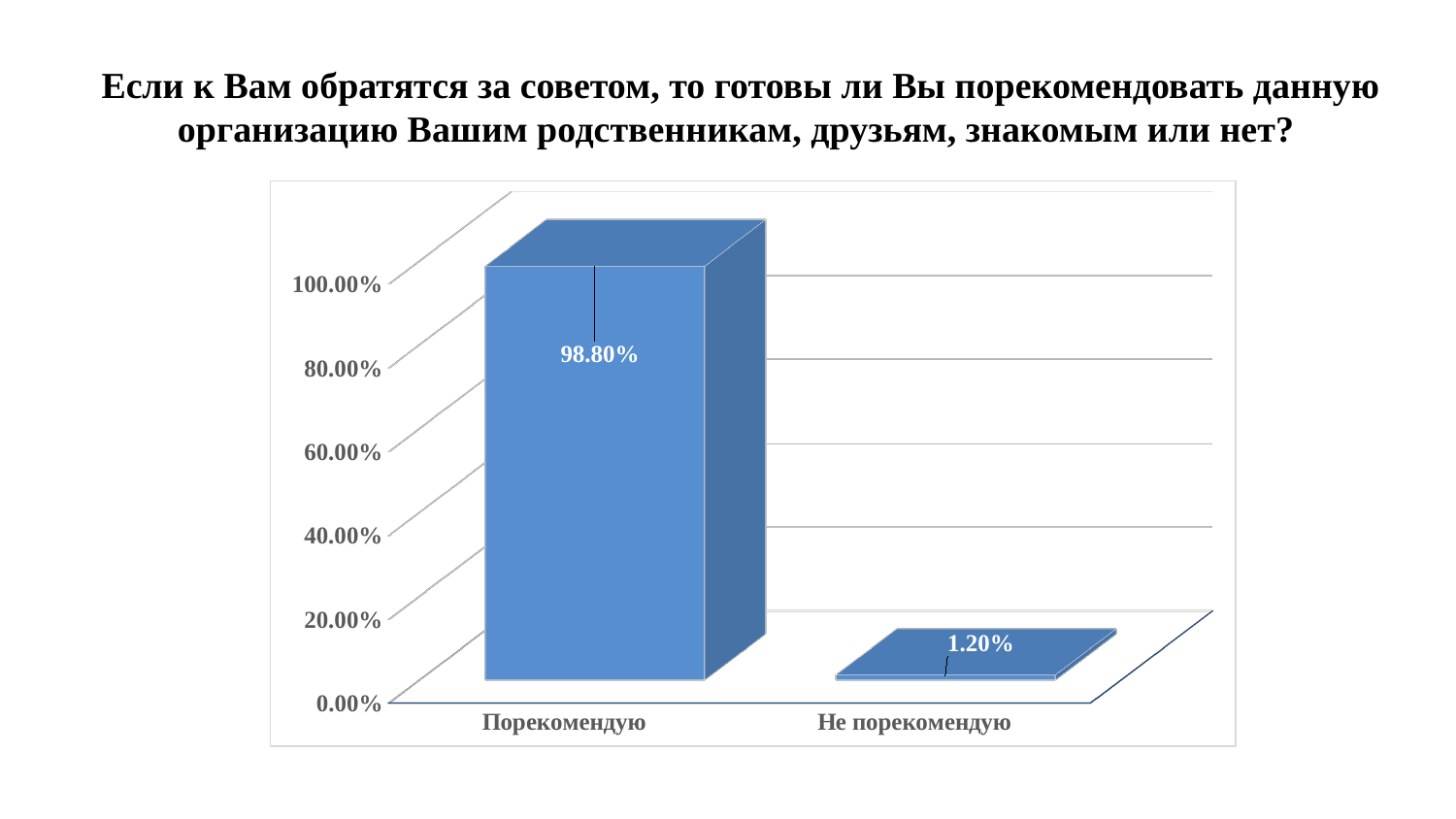
How many categories are shown on the x axis? 2 Is the value for "Не порекомендую" greater or less than 20.00%? less Which category has the highest value? Порекомендую What kind of chart is shown on the slide? bar chart What is the difference between the values for "Порекомендую" and "Не порекомендую"? 97.60% Do the values rise or fall from left to right along the x axis? fall Is the value for "Порекомендую" greater or less than 80.00%? greater Which category has the lowest value? Не порекомендую Which is larger, the value for "Порекомендую" or the value for "Не порекомендую"? Порекомендую What is the value for "Порекомендую"? 98.80% What is the total of the two values shown in the chart? 100.00% What is the value for "Не порекомендую"? 1.20%